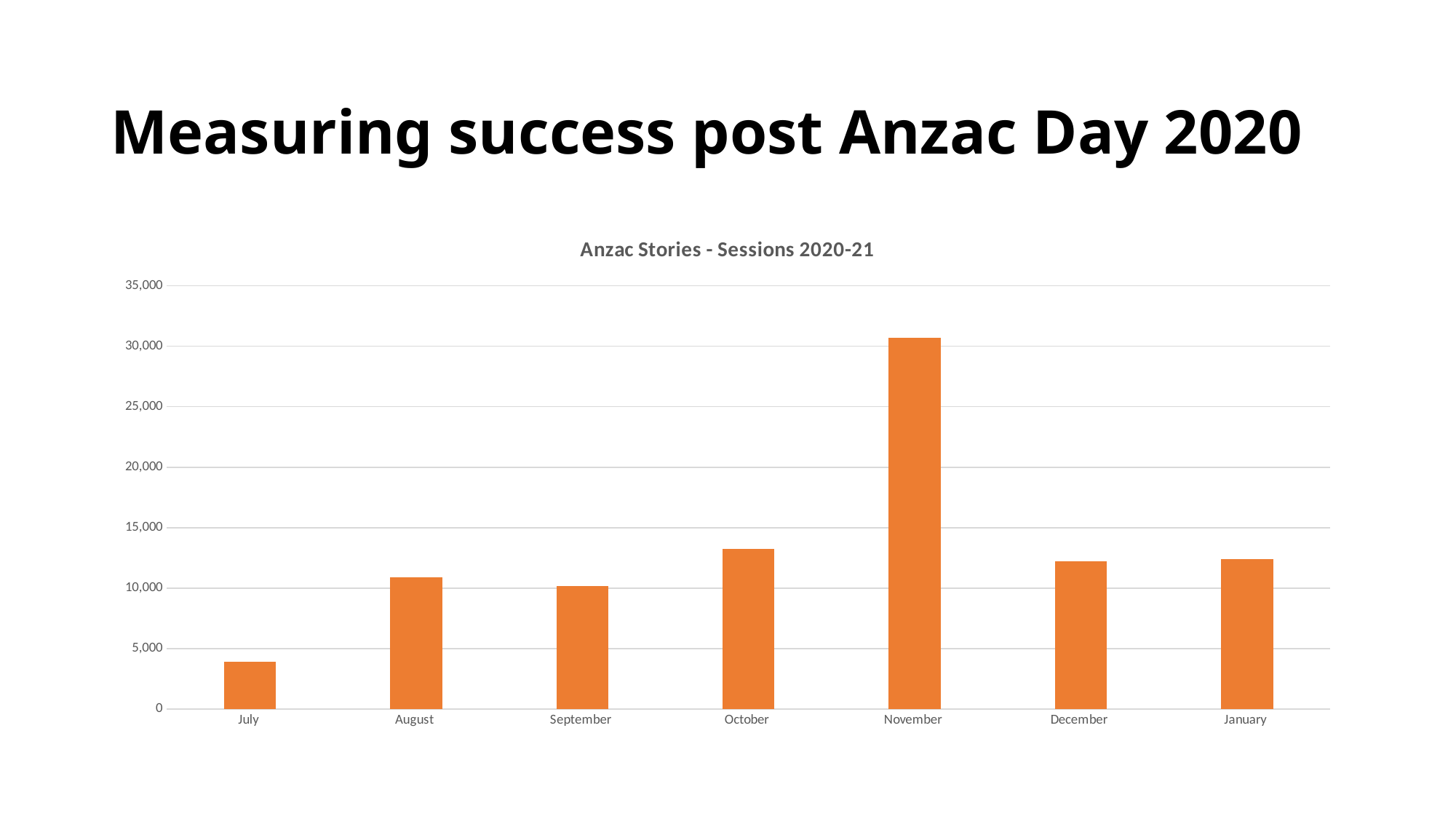
Which month has more sessions, July or September? September Is the value for July greater or less than 5,000? less How many months are shown on the x axis of the chart? 7 Do the sessions rise or fall from July to August? rise Which month has more sessions, October or December? October Which month has the lowest number of sessions? July What type of chart is shown on the slide? Bar chart Is the value for November greater or less than 30,000? greater Is the value for August greater or less than 10,000? greater Which month has the highest number of sessions? November What is the title of the chart? Anzac Stories - Sessions 2020-21